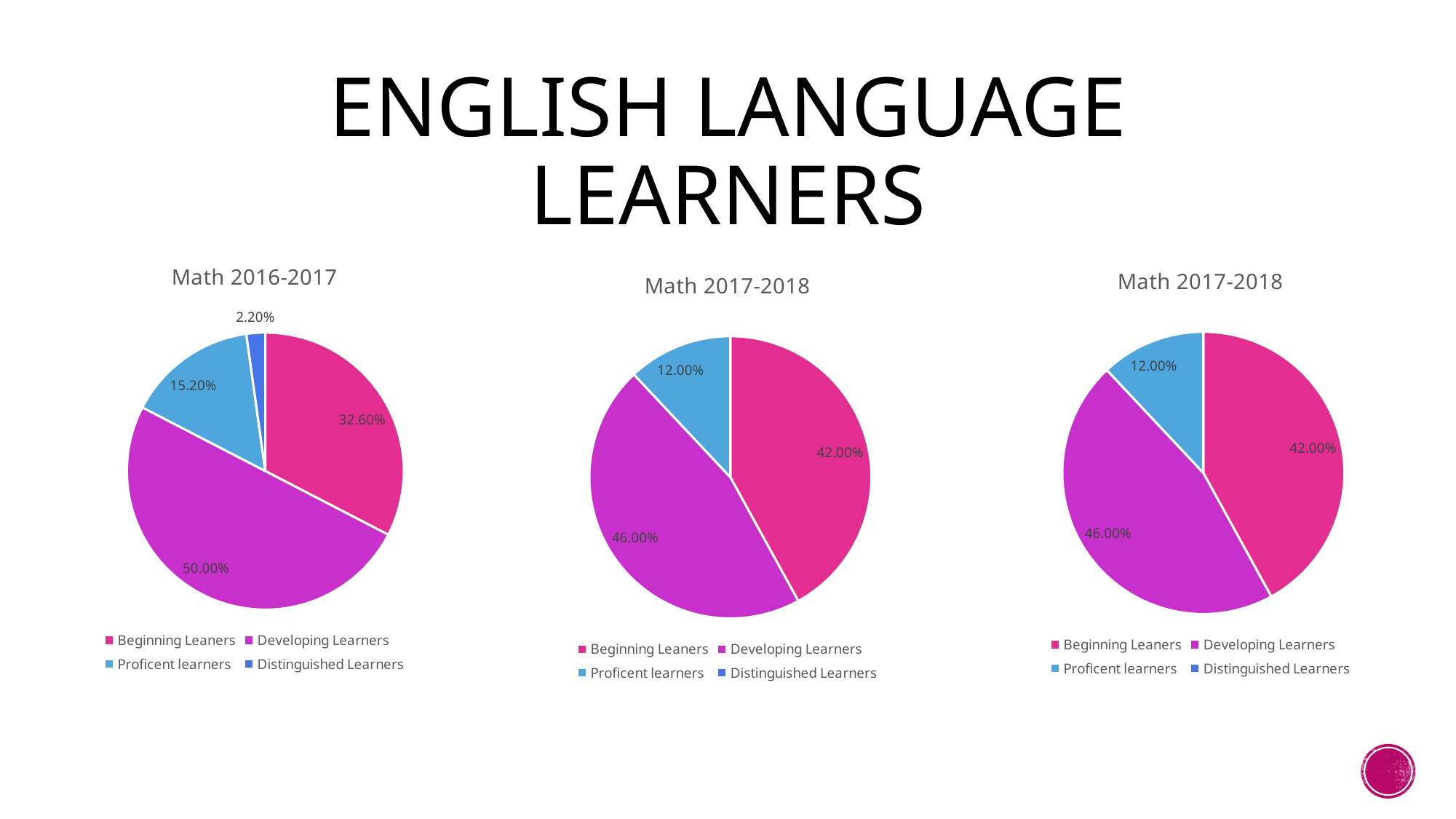
In the left chart (Math 2016-2017), what share of the pie is Distinguished Learners? 2.20% In the middle chart (Math 2017-2018), what is the value for Proficent learners? 12.00% In the middle chart (Math 2017-2018), what is the value for Beginning Leaners? 42.00% In the left chart (Math 2016-2017), which category has the largest slice? Developing Learners In the left chart (Math 2016-2017), which category has the smallest slice? Distinguished Learners In the right chart (Math 2017-2018), what is the difference between the Developing Learners and Proficent learners slices? 34.00% In the right chart (Math 2017-2018), which is larger, Developing Learners or Beginning Leaners? Developing Learners In the left chart (Math 2016-2017), what is the value for Proficent learners? 15.20% In the left chart (Math 2016-2017), what share of the pie is Developing Learners? 50.00% What type of chart is used on this slide? Pie chart How many entries does the legend of the left chart (Math 2016-2017) list? 4 In the left chart (Math 2016-2017), what is the difference between the Developing Learners and Beginning Leaners slices? 17.40%